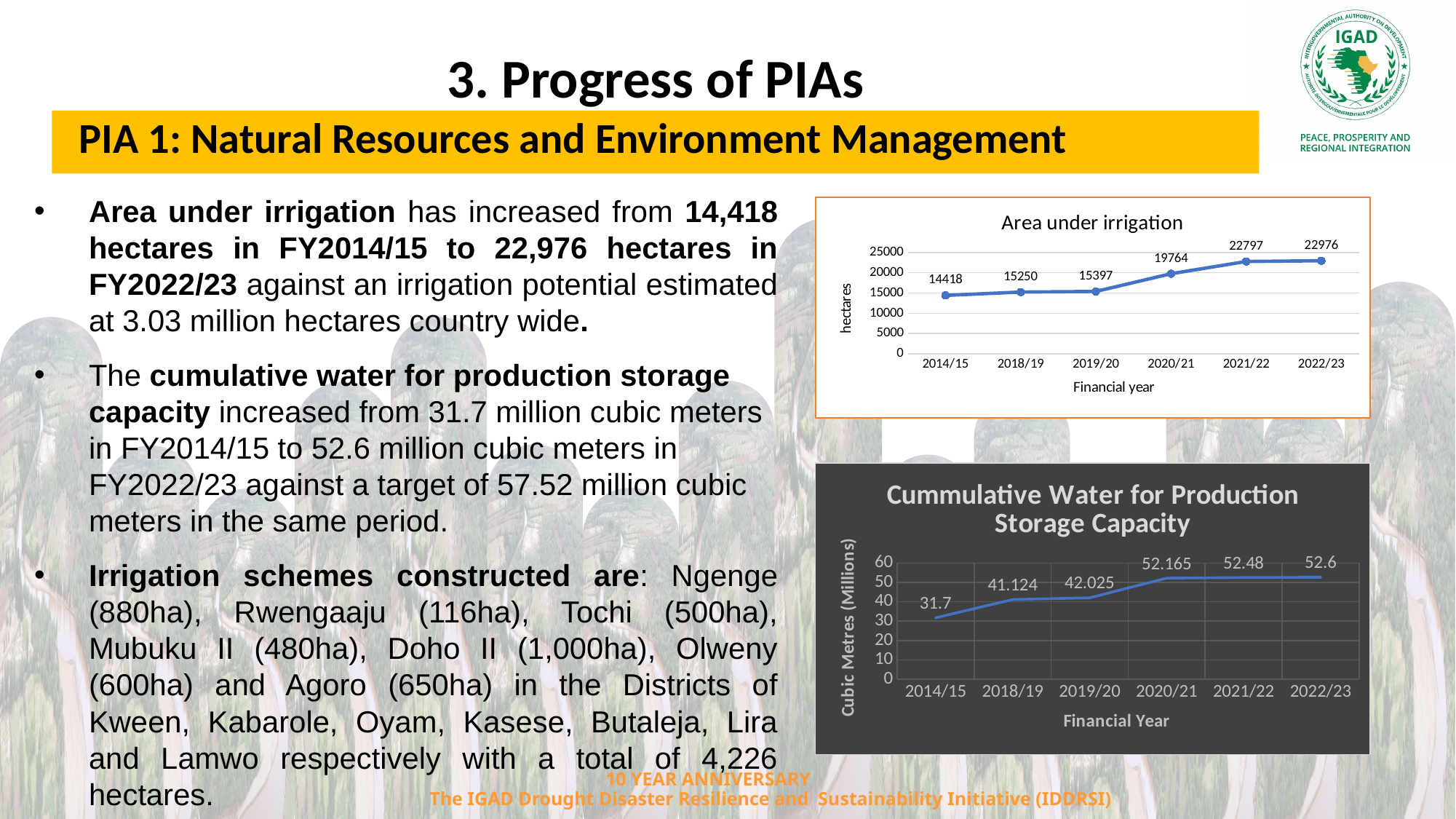
In the 'Area under irrigation' chart, what type of chart is shown? Line chart In the 'Area under irrigation' chart, which financial year has the highest value? 2022/23 In the 'Area under irrigation' chart, what is the value for 2020/21? 19764 In the 'Cummulative Water for Production Storage Capacity' chart, what is the y-axis label? Cubic Metres (Millions) In the 'Cummulative Water for Production Storage Capacity' chart, what is the value for 2019/20? 42.025 In the 'Area under irrigation' chart, what is the difference between the values for 2022/23 and 2014/15? 8558 In the 'Area under irrigation' chart, do the values rise or fall from 2014/15 to 2022/23? Rise In the 'Area under irrigation' chart, how many financial years are plotted? 6 In the 'Area under irrigation' chart, which financial year has the lowest value? 2014/15 In the 'Cummulative Water for Production Storage Capacity' chart, what is the difference between the values for 2018/19 and 2014/15? 9.424 In the 'Cummulative Water for Production Storage Capacity' chart, what is the value for 2014/15? 31.7 In the 'Cummulative Water for Production Storage Capacity' chart, which is larger, the value for 2018/19 or 2020/21? 2020/21